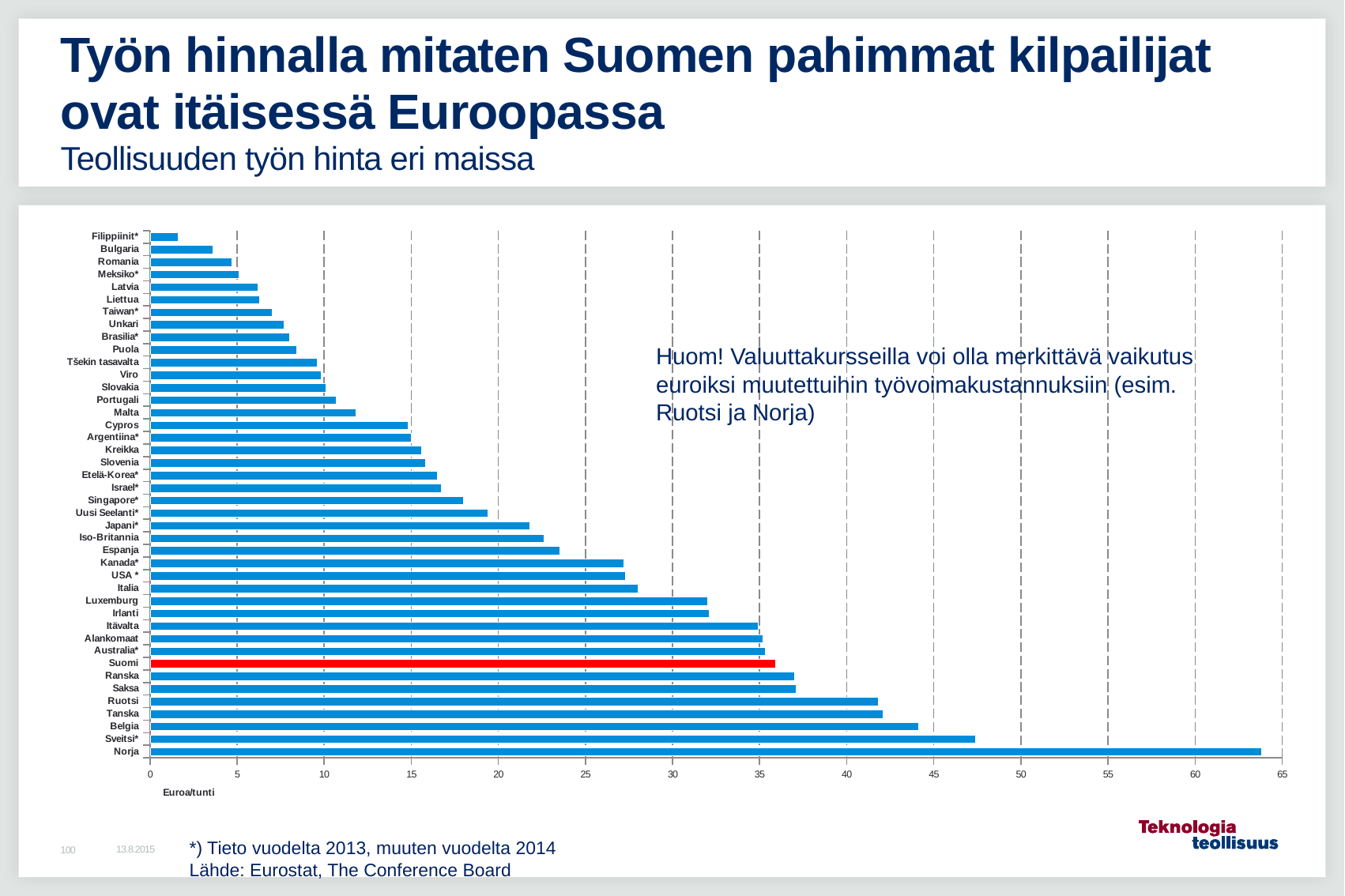
Is the value for Filippiinit* greater or less than 5? less What kind of chart is shown on the slide? bar chart Is the value for Belgia greater or less than 45? less Which country's bar is highlighted in red? Suomi Which country has the lowest industrial labour cost in the chart? Filippiinit* Is the value for Norja greater or less than 60? greater Which has a higher value, Norja or Sveitsi*? Norja How many countries are shown in the chart? 42 Which country has the highest industrial labour cost in the chart? Norja Which has a higher value, Belgia or Tanska? Belgia